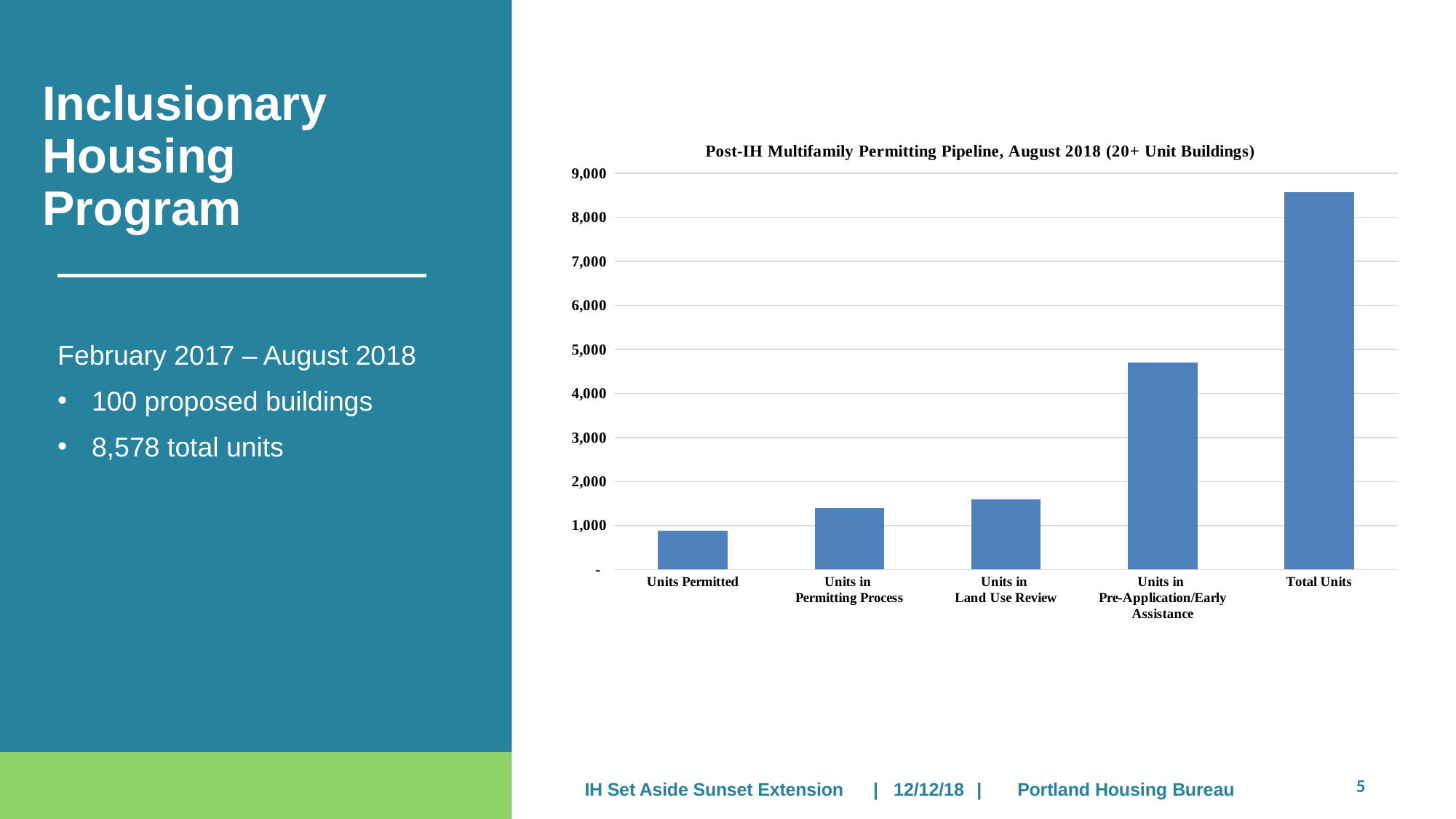
Is the value for Units in Permitting Process greater or less than 1,000? greater Is the value for Units Permitted greater or less than 1,000? less How many categories are plotted on the chart? 5 Is the value for Total Units greater or less than 8,000? greater What is the title of the chart? Post-IH Multifamily Permitting Pipeline, August 2018 (20+ Unit Buildings) Do the bar values rise or fall from left to right across the categories? rise What kind of chart is shown on the slide? bar chart Which category has the highest value? Total Units Which category has the lowest value? Units Permitted Which is larger: Units in Pre-Application/Early Assistance or Units in Land Use Review? Units in Pre-Application/Early Assistance